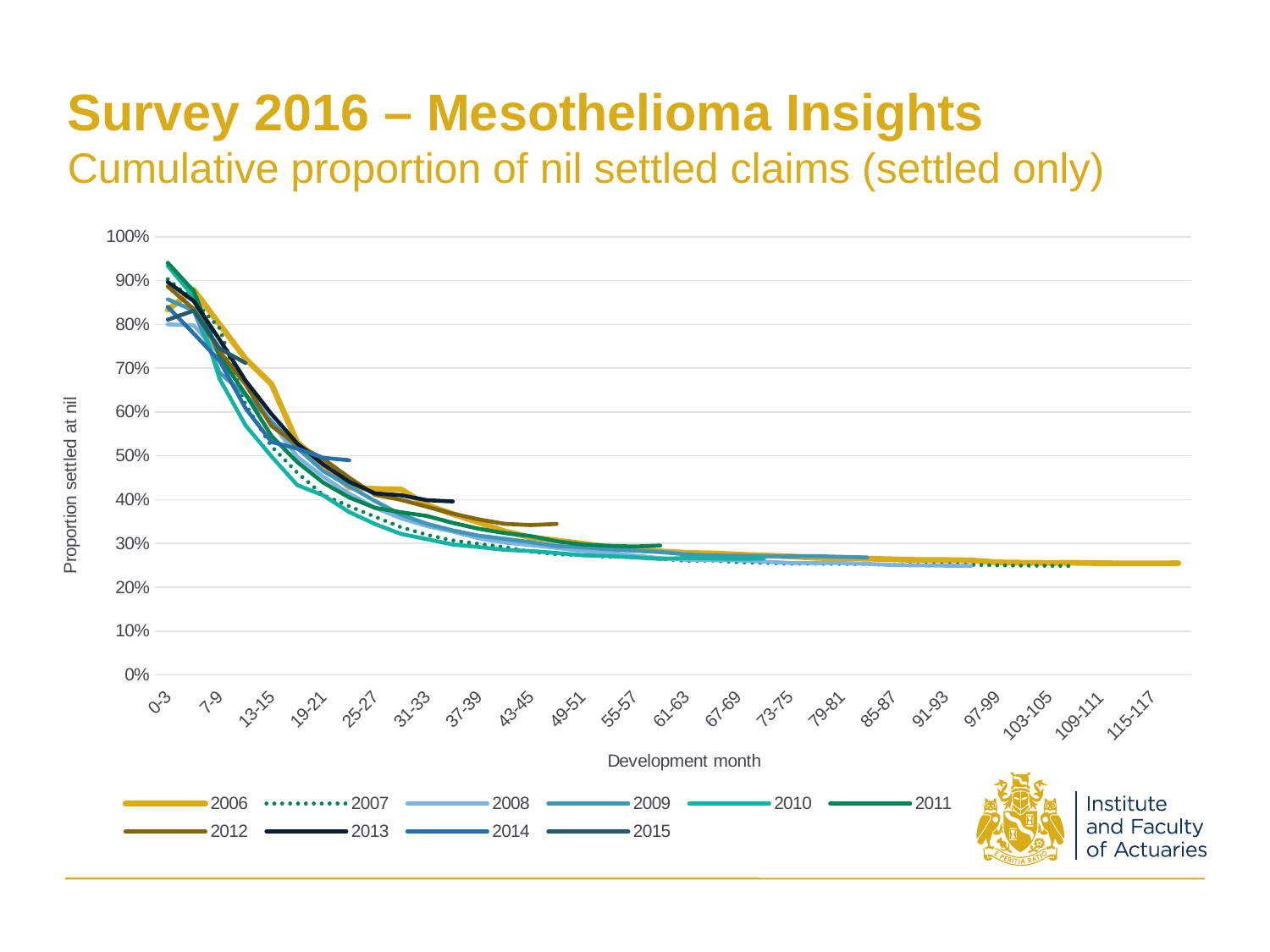
Is the value for 2006 at development month 115-117 greater or less than 30%? less Which series is drawn with a dotted line in the legend? 2007 Is the value for 2012 at development month 43-45 greater or less than 40%? less Which series starts highest at development month 0-3? 2011 What kind of chart is shown on the slide? Line chart Which series extends furthest along the x axis, reaching development month 115-117? 2006 Do the values generally rise or fall as development month increases? Fall How many series does the legend list? 10 Is the value for 2010 at development month 0-3 greater or less than 90%? greater At development month 13-15, which is larger, the value for 2006 or the value for 2010? 2006 What is the label of the vertical axis? Proportion settled at nil